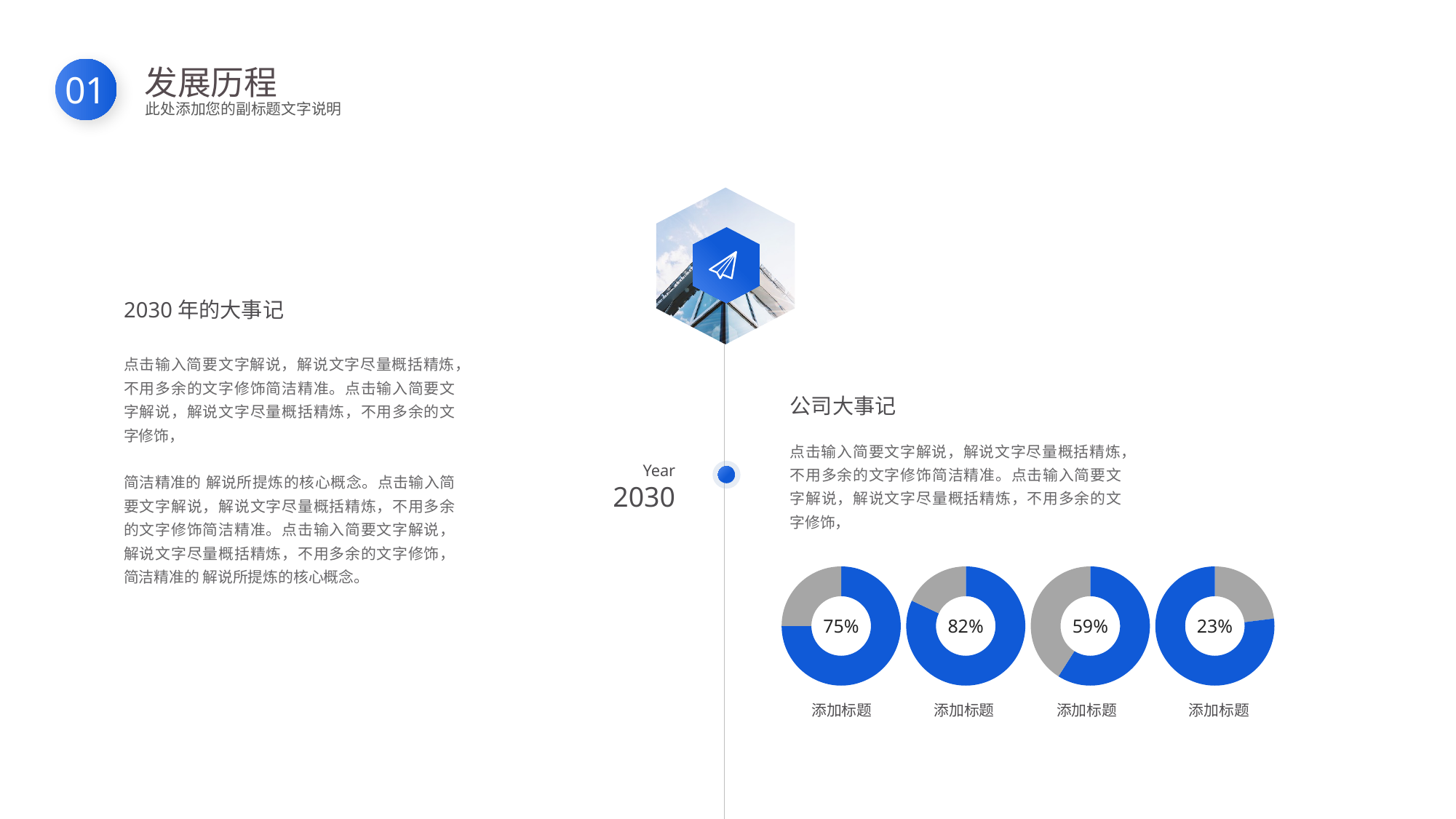
What is the difference between the percentage in the leftmost donut chart and the percentage in the third donut chart? 16% What value is shown in the centre of the third donut chart from the left? 59% What value is shown in the centre of the leftmost donut chart? 75% What kind of chart is used to display the four percentages on the slide? Donut chart What colour is used for the filled (percentage) portion of each donut chart? Blue What is the difference between the percentage in the second donut chart and the percentage in the rightmost donut chart? 59% Which is larger, the percentage in the leftmost donut chart or the percentage in the third donut chart? The leftmost (75%) What value is shown in the centre of the second donut chart from the left? 82% Which donut chart shows the lowest percentage? The rightmost (23%) What value is shown in the centre of the rightmost donut chart? 23% How many donut charts are shown on the slide? 4 Which donut chart shows the highest percentage? The second from the left (82%)